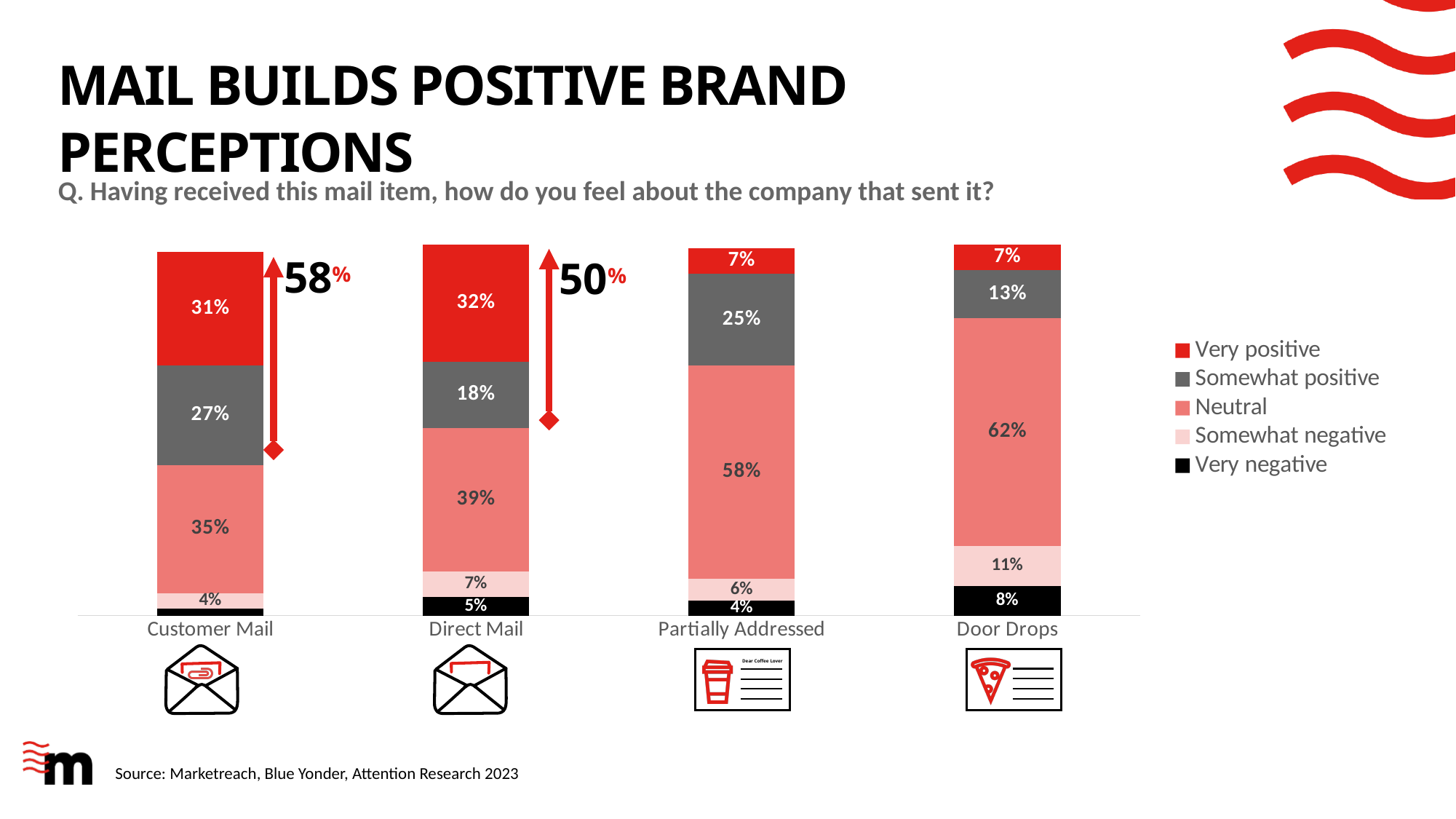
How many series does the legend list? 5 Which mail type has the highest Neutral share? Door Drops How many mail types are shown on the x axis? 4 What is the Very negative value for Direct Mail? 5% Which is larger: the Somewhat negative value for Door Drops or for Direct Mail? Door Drops What is the Neutral value for Door Drops? 62% What kind of chart is shown on the slide? Stacked bar chart What is the difference between the Very positive values for Direct Mail and Customer Mail? 1% What percentage of Customer Mail recipients felt very positive about the company that sent it? 31% What is the Somewhat positive value for Partially Addressed mail? 25% What is the combined Very positive and Somewhat positive share for Customer Mail, as annotated on the chart? 58% Which mail type has the lowest Somewhat positive share? Door Drops